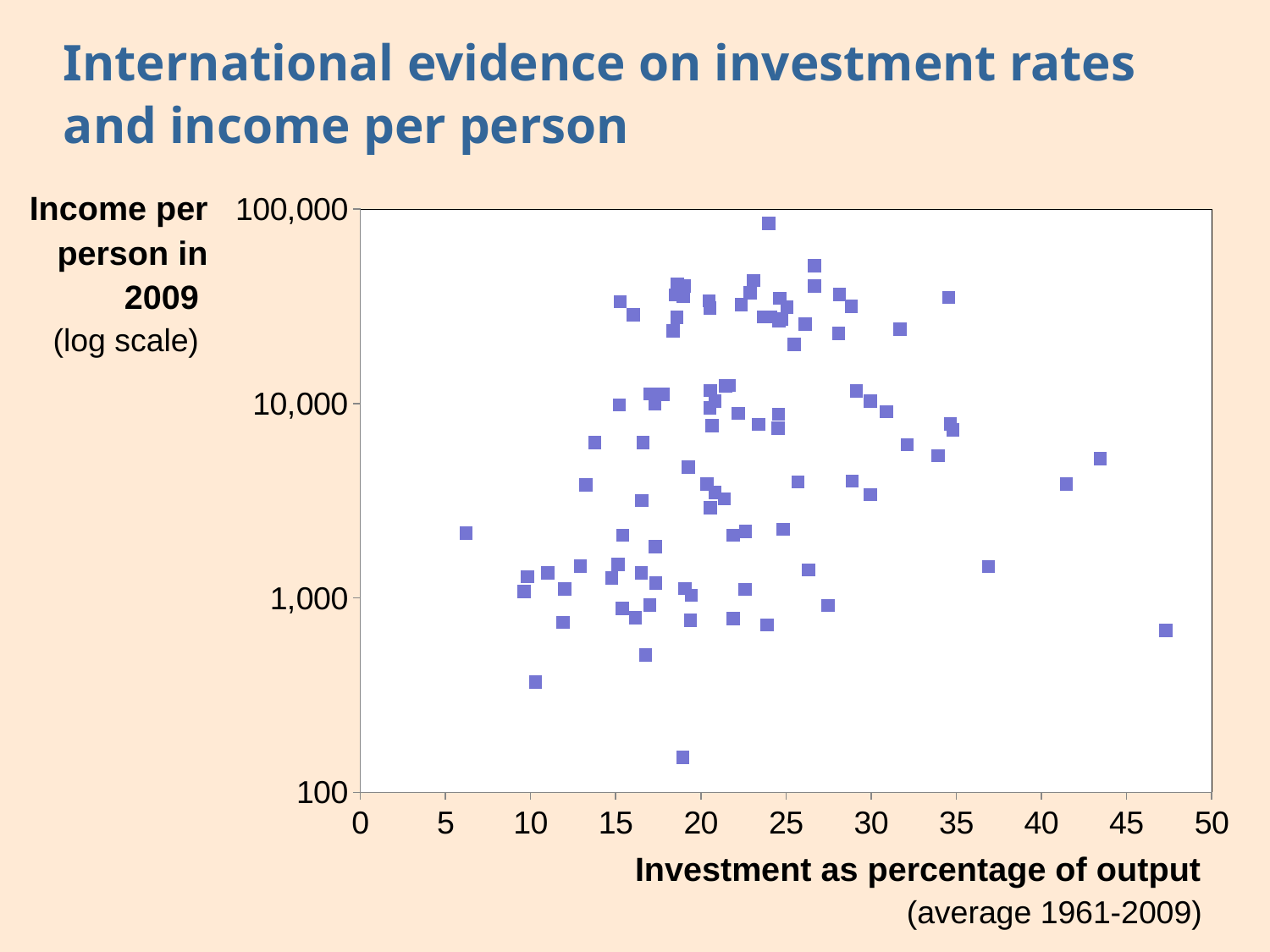
Is the income per person of the highest plotted point greater or less than 10,000? greater Is the income per person of the lowest plotted point greater or less than 1,000? less What is the label of the horizontal axis? Investment as percentage of output Is the investment rate of the leftmost plotted point greater or less than 10? less What kind of chart is shown on the slide? scatter plot What type of scale is used on the vertical axis? log scale As investment as a percentage of output increases along the x axis, does income per person tend to rise or fall? rise